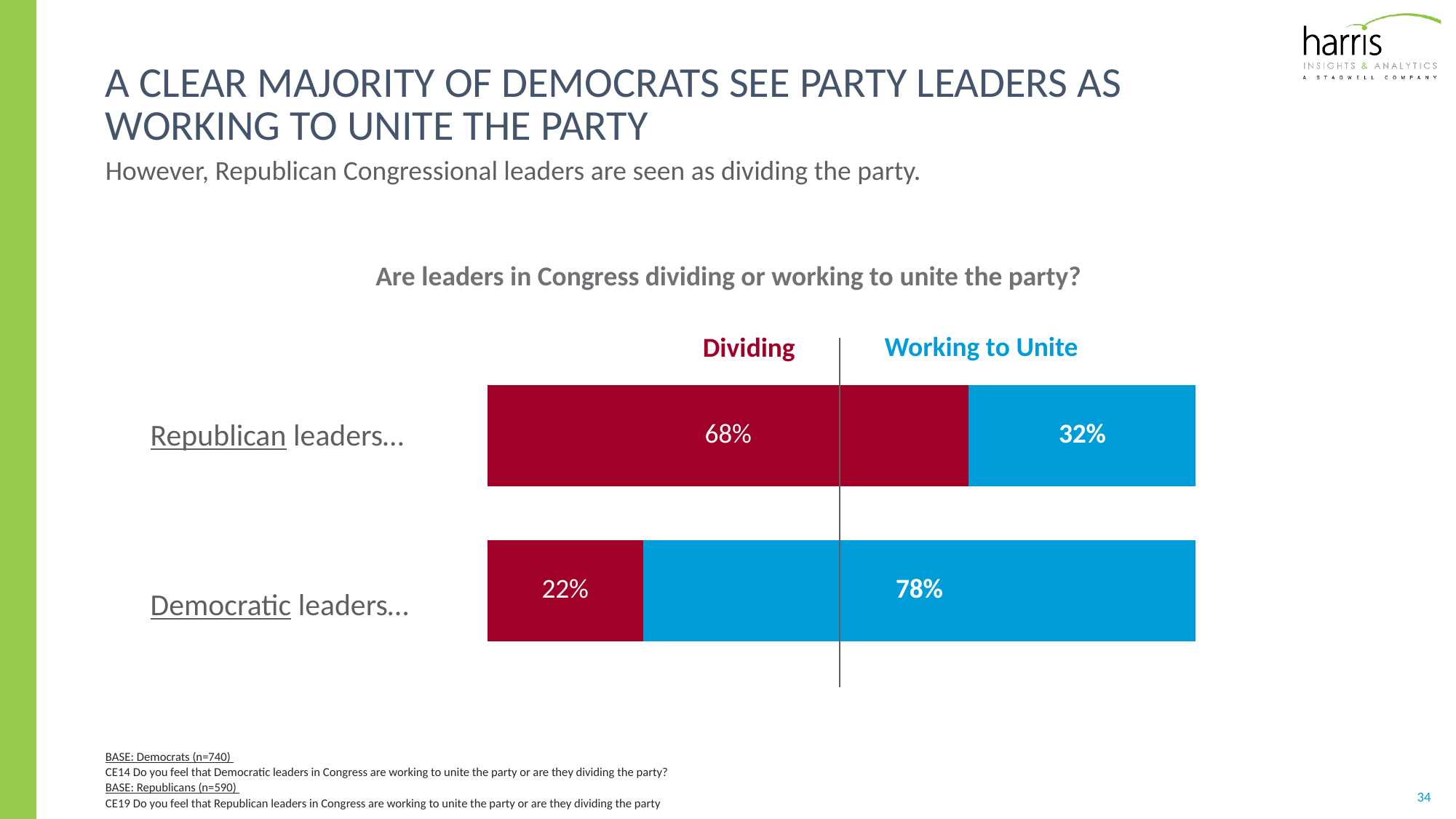
What percentage say Democratic leaders are working to unite the party? 78% How many series does the chart show? 2 What percentage say Democratic leaders are dividing the party? 22% What is the total of the two segments in the Democratic leaders bar? 100% For Republican leaders, is the 'Dividing' share larger or the 'Working to Unite' share larger? Dividing What type of chart is shown on the slide? Stacked bar chart What percentage say Republican leaders are dividing the party? 68% Which group of leaders has the lower 'Dividing' percentage? Democratic leaders What percentage say Republican leaders are working to unite the party? 32% Which group of leaders has the higher 'Working to Unite' percentage? Democratic leaders What is the difference between the 'Dividing' percentages for Republican leaders and Democratic leaders? 46 percentage points How many categories (rows) are shown in the chart? 2